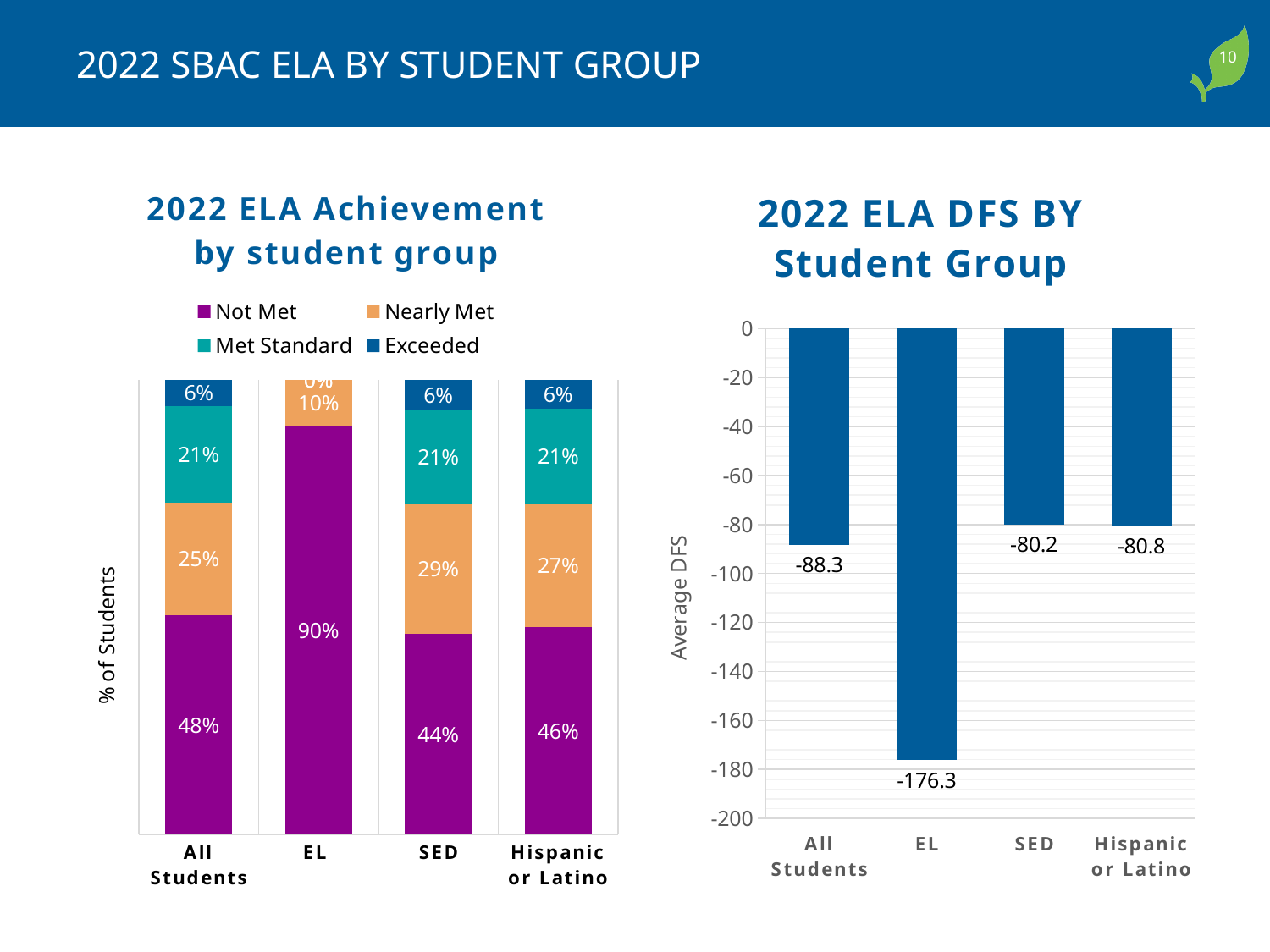
In the '2022 ELA Achievement by student group' chart, which student group has the highest Not Met percentage? EL In the '2022 ELA Achievement by student group' chart, is the Not Met percentage larger for SED or for Hispanic or Latino students? Hispanic or Latino In the '2022 ELA DFS BY Student Group' chart, what is the difference between the average DFS for SED and for All Students? 8.1 In the '2022 ELA Achievement by student group' chart, how many series does the legend list? 4 In the '2022 ELA DFS BY Student Group' chart, what is the average DFS for EL? -176.3 In the '2022 ELA DFS BY Student Group' chart, what is the average DFS for All Students? -88.3 What kind of chart is the '2022 ELA DFS BY Student Group' chart? Bar chart In the '2022 ELA DFS BY Student Group' chart, which student group has the lowest average DFS? EL In the '2022 ELA DFS BY Student Group' chart, how many student groups are shown? 4 In the '2022 ELA Achievement by student group' chart, what is the difference between the Nearly Met percentages for SED and All Students? 4% In the '2022 ELA Achievement by student group' chart, what percentage of All Students are in the Not Met category? 48% In the '2022 ELA Achievement by student group' chart, what percentage of SED students are in the Nearly Met category? 29%